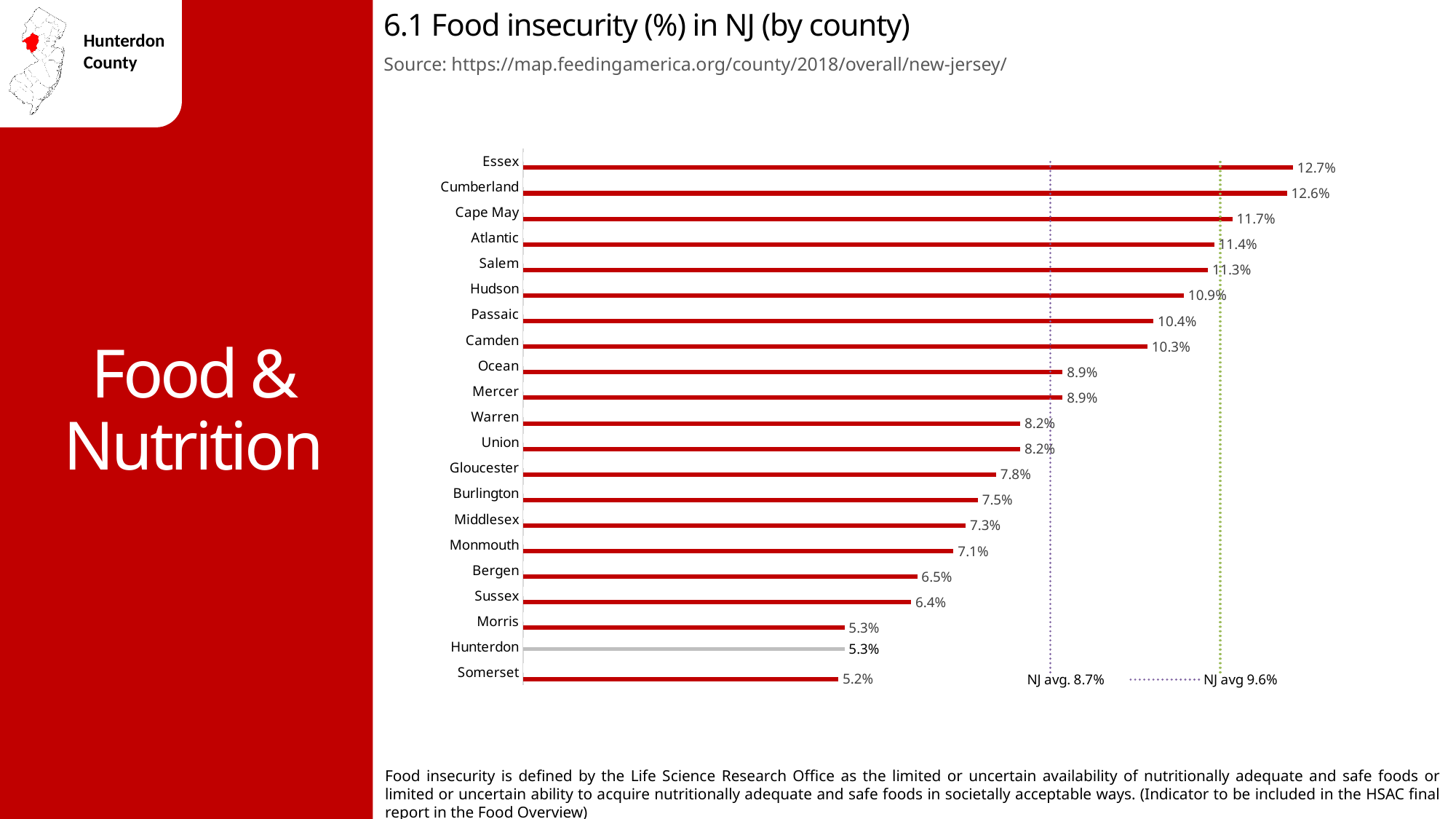
What NJ average values are marked by the dotted reference lines on the chart? 8.7% and 9.6% Which county has a higher food insecurity percentage, Bergen or Monmouth? Monmouth What is the food insecurity percentage for Middlesex County? 7.3% Which county has a higher food insecurity percentage, Hudson or Passaic? Hudson How many counties are shown in the chart? 21 What is the food insecurity percentage for Hunterdon County? 5.3% What is the difference in food insecurity percentage between Essex and Hunterdon? 7.4% What is the difference in food insecurity percentage between Cumberland and Cape May? 0.9% What type of chart is used to show food insecurity by county? Bar chart Which county has the highest food insecurity percentage? Essex Which county has the lowest food insecurity percentage? Somerset What is the food insecurity percentage for Essex County? 12.7%